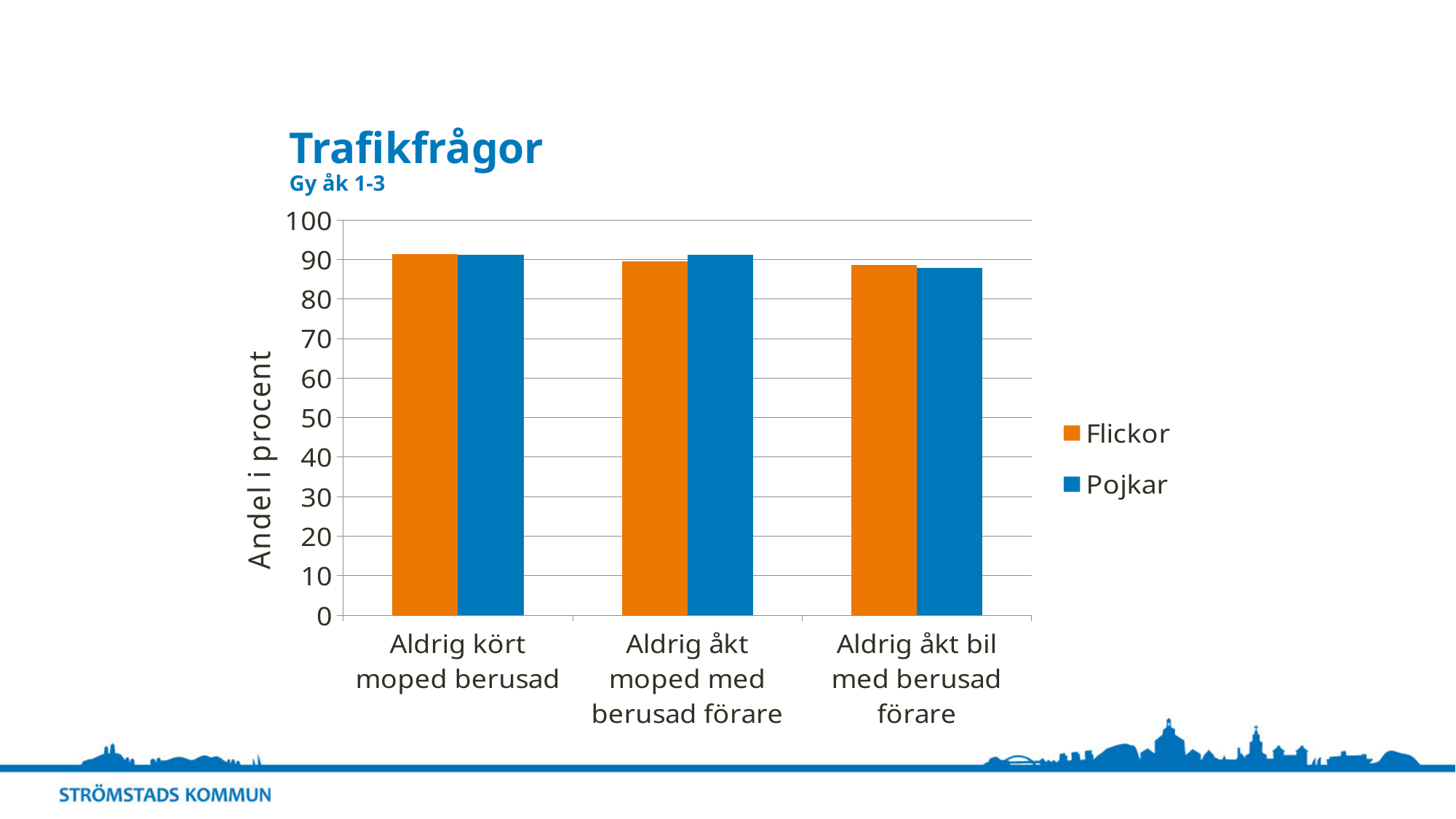
Is the Flickor value for 'Aldrig kört moped berusad' greater or less than 80? greater How many categories are shown on the x axis of the chart? 3 How many series does the legend list? 2 What kind of chart is shown on the slide? bar chart Is the Flickor value for 'Aldrig åkt bil med berusad förare' greater or less than 90? less What is the label on the vertical axis of the chart? Andel i procent Is the Flickor value for 'Aldrig åkt moped med berusad förare' greater or less than 70? greater What is the title of the chart? Trafikfrågor